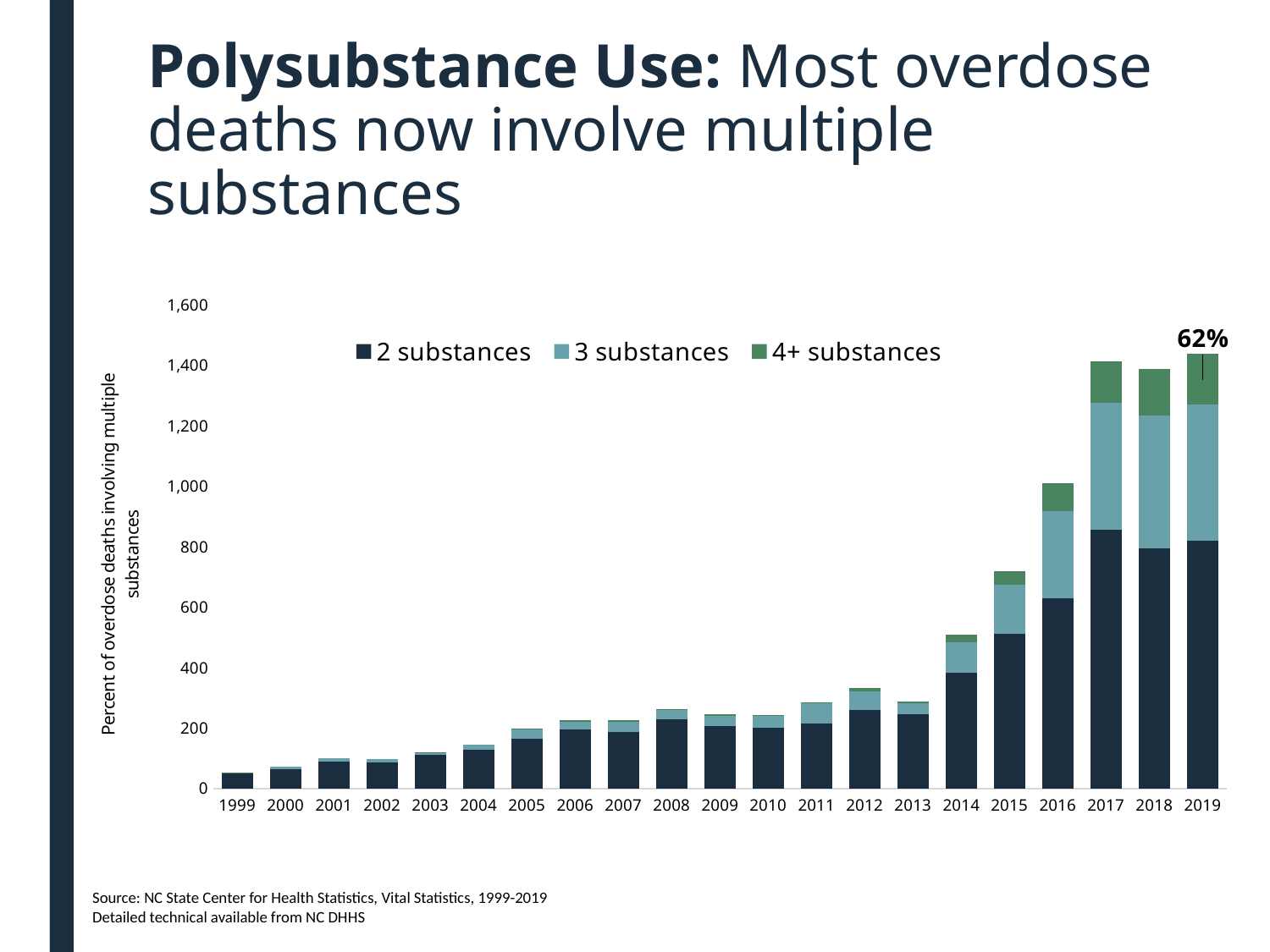
Which year has the larger total bar, 2005 or 2010? 2010 Is the total bar for 2017 greater or less than 1,200? greater Which year has the larger total bar, 2018 or 2016? 2018 What percentage is annotated above the 2019 bar? 62% Is the total bar for 1999 greater or less than 200? less What kind of chart is shown on the slide? Stacked bar chart Which year has the lowest total bar? 1999 Is the 2 substances segment for 2017 greater or less than 600? greater How many series does the legend list? 3 How many years are shown along the x axis? 21 Do the total bar heights generally rise or fall from 1999 to 2017? Rise What are the three series named in the legend? 2 substances, 3 substances, 4+ substances